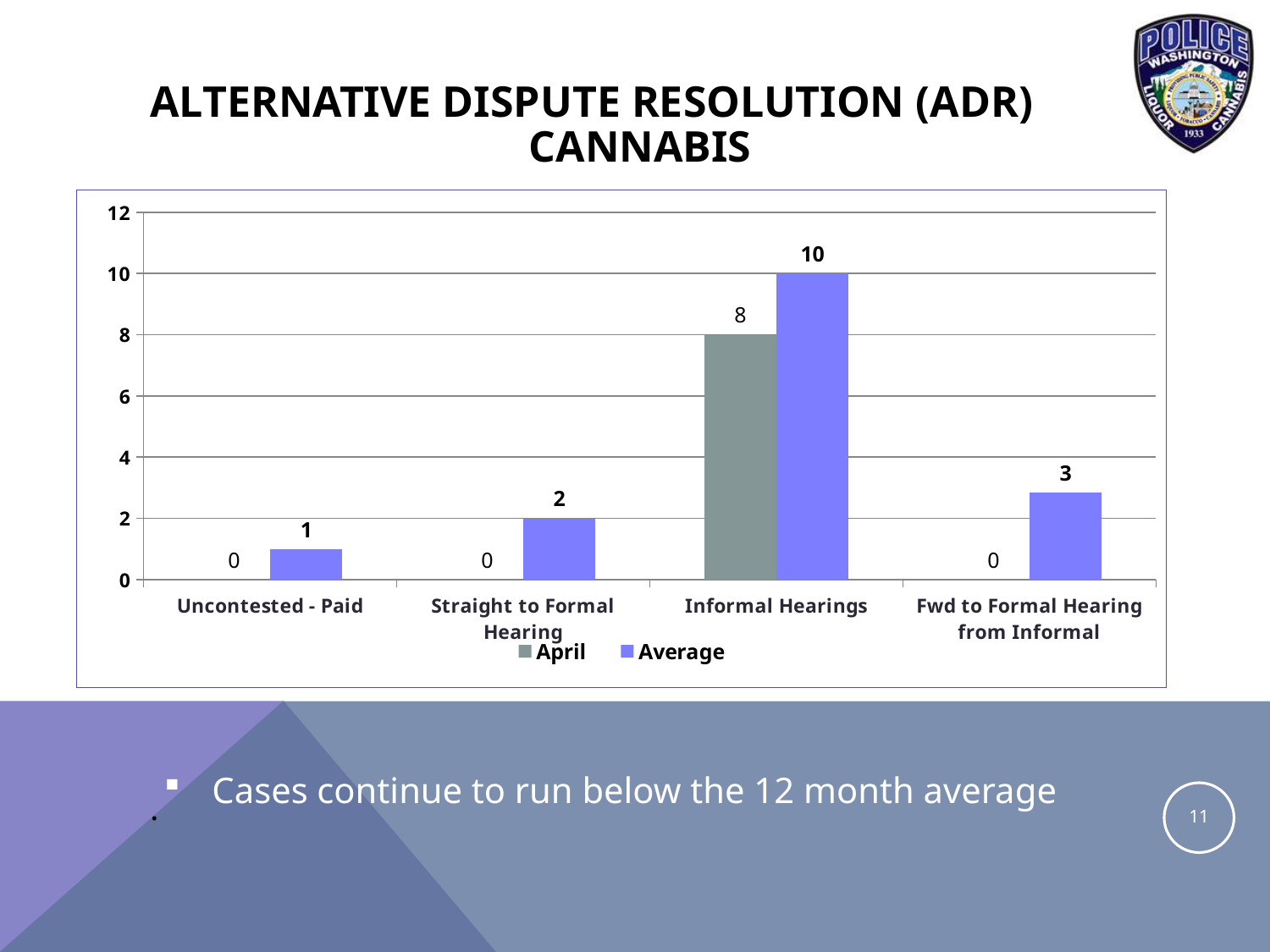
What is the Average value for Informal Hearings? 10 What is the April value for Uncontested - Paid? 0 What is the Average value for Straight to Formal Hearing? 2 For Informal Hearings, which is larger, the April value or the Average value? Average What is the difference between the Average and April values for Informal Hearings? 2 How many series does the legend list? 2 What kind of chart is shown on the slide? Bar chart What is the April value for Informal Hearings? 8 How many categories are shown on the x axis? 4 What is the Average value for Fwd to Formal Hearing from Informal? 3 Which category has the highest Average value? Informal Hearings Which category has the lowest Average value? Uncontested - Paid